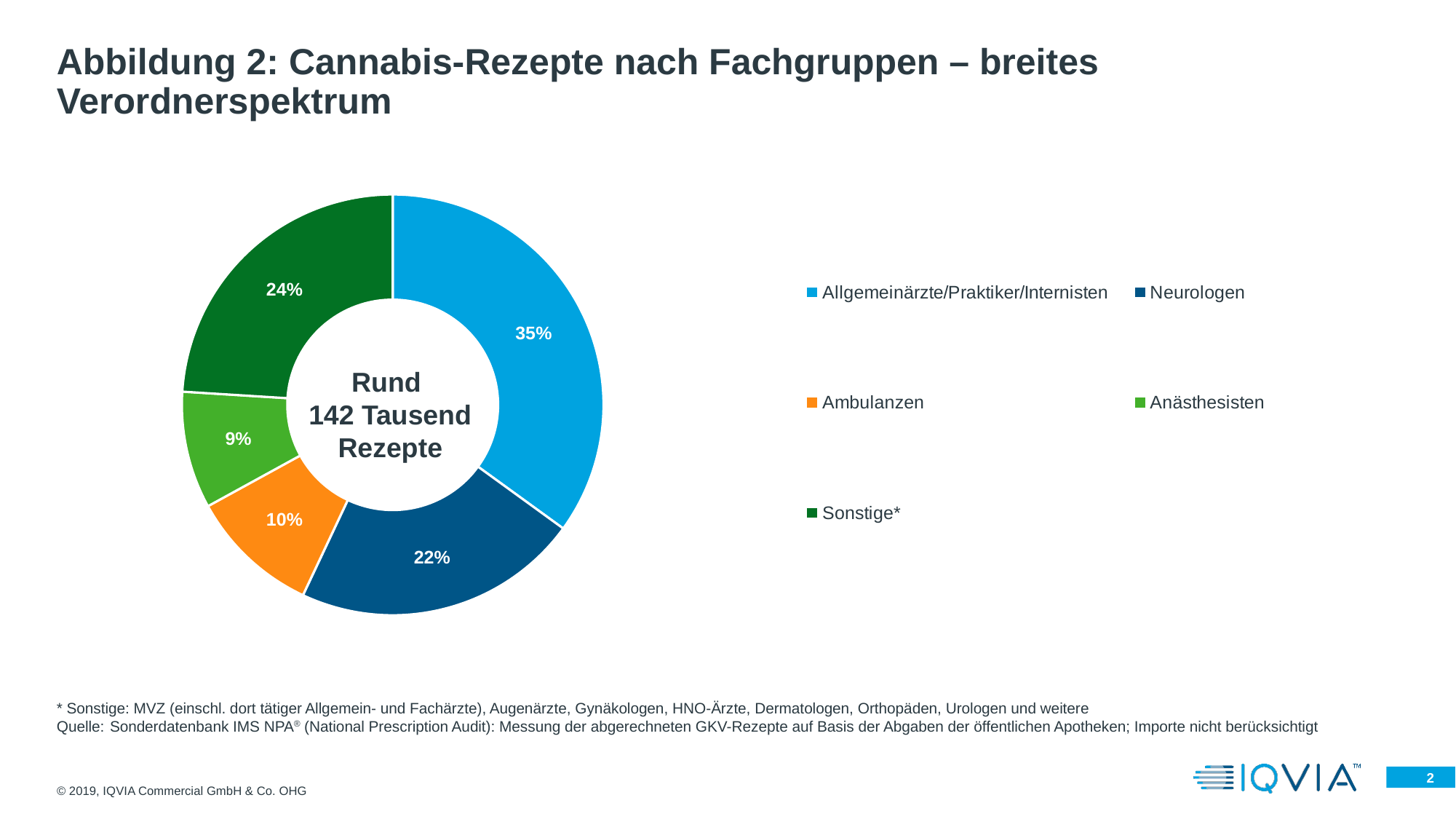
What share of cannabis prescriptions is attributed to Allgemeinärzte/Praktiker/Internisten? 35% Which specialist group has the largest share of cannabis prescriptions? Allgemeinärzte/Praktiker/Internisten What share of cannabis prescriptions is attributed to Ambulanzen? 10% What total number of prescriptions is stated in the centre of the donut chart? Rund 142 Tausend Rezepte What kind of chart is shown on the slide? Pie chart (donut) Which has a larger share, Sonstige* or Neurologen? Sonstige* What share of cannabis prescriptions is attributed to Neurologen? 22% How many categories does the pie chart show? 5 What share of cannabis prescriptions is attributed to Anästhesisten? 9% What share of cannabis prescriptions is attributed to Sonstige*? 24% Which specialist group has the smallest share of cannabis prescriptions? Anästhesisten How many percentage points larger is the share of Allgemeinärzte/Praktiker/Internisten than that of Neurologen? 13 percentage points